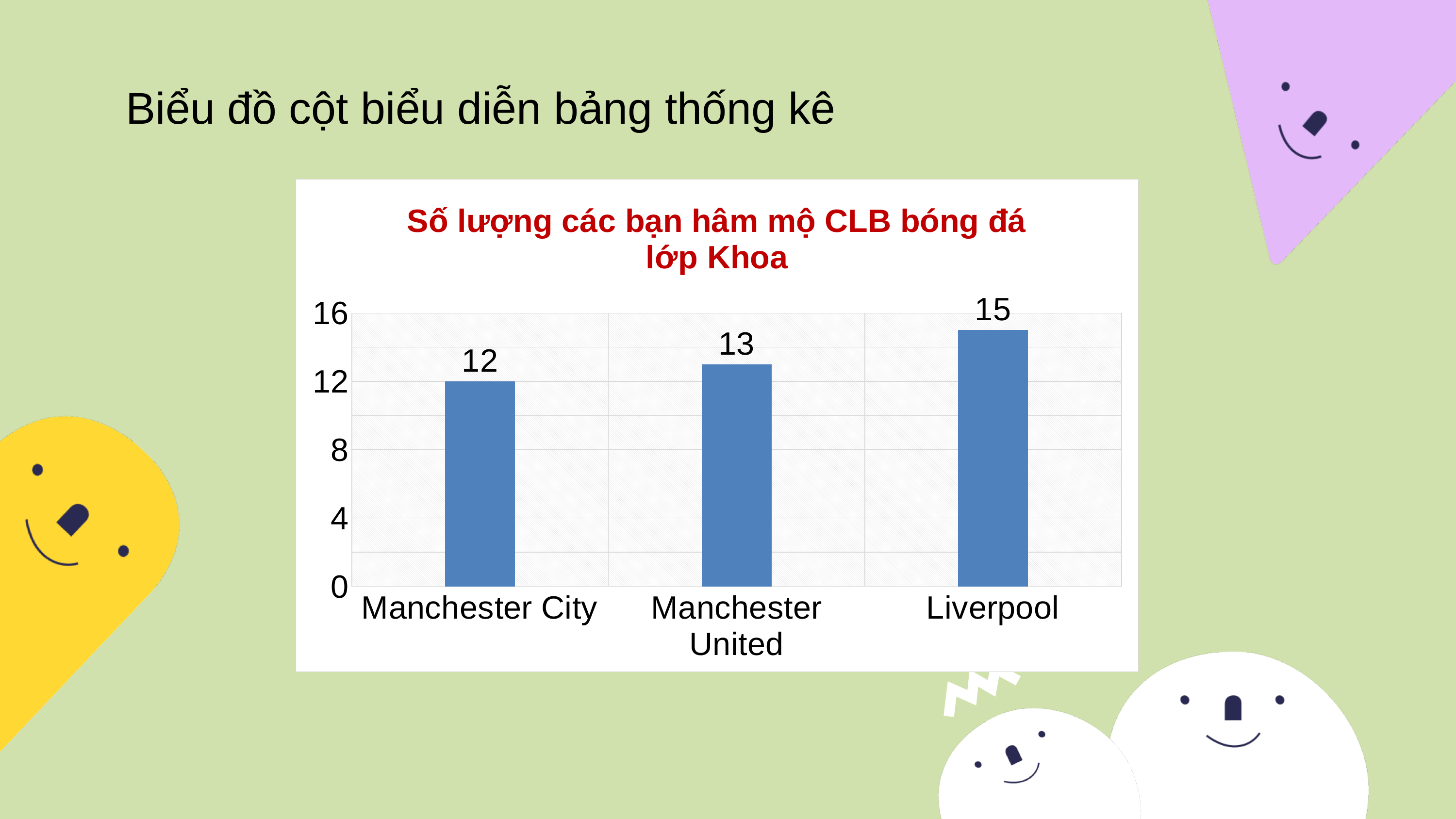
What is the difference between the values for Liverpool and Manchester City? 3 What is the title of the chart? Số lượng các bạn hâm mộ CLB bóng đá lớp Khoa Which club has the lowest value? Manchester City What is the difference between the values for Manchester United and Manchester City? 1 What is the value for Liverpool? 15 How many clubs are shown on the chart? 3 Which club has the highest value? Liverpool Which is larger, the value for Liverpool or the value for Manchester United? Liverpool What is the value for Manchester City? 12 What is the value for Manchester United? 13 Is the value for Liverpool greater or less than 12? greater What kind of chart is shown on the slide? bar chart